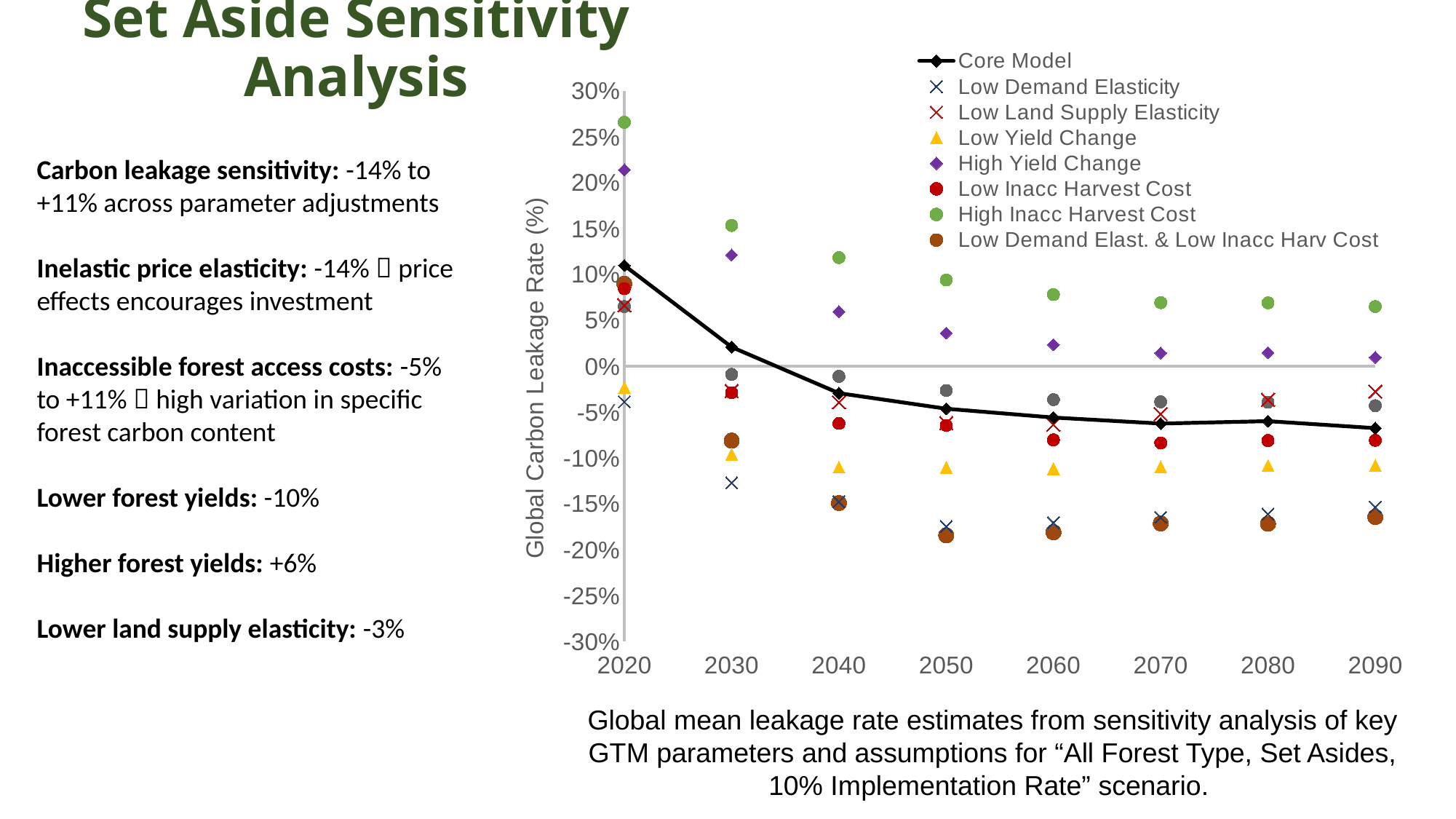
Which series is drawn as a black line with diamond markers? Core Model What is the title of the chart's vertical axis? Global Carbon Leakage Rate (%) Which series has the highest value in 2020? High Inacc Harvest Cost Which series has the lowest value in 2030? Low Demand Elasticity Is the value for Low Demand Elast. & Low Inacc Harv Cost in 2050 greater or less than -15%? less In 2090, which is larger: the value for High Inacc Harvest Cost or the value for High Yield Change? High Inacc Harvest Cost Is the value for Core Model in 2020 greater or less than 10%? greater How many years are shown along the x axis of the chart? 8 Does the Core Model series rise or fall from 2020 to 2090? fall Is the value for Core Model in 2090 greater or less than -5%? less How many series does the chart legend list? 8